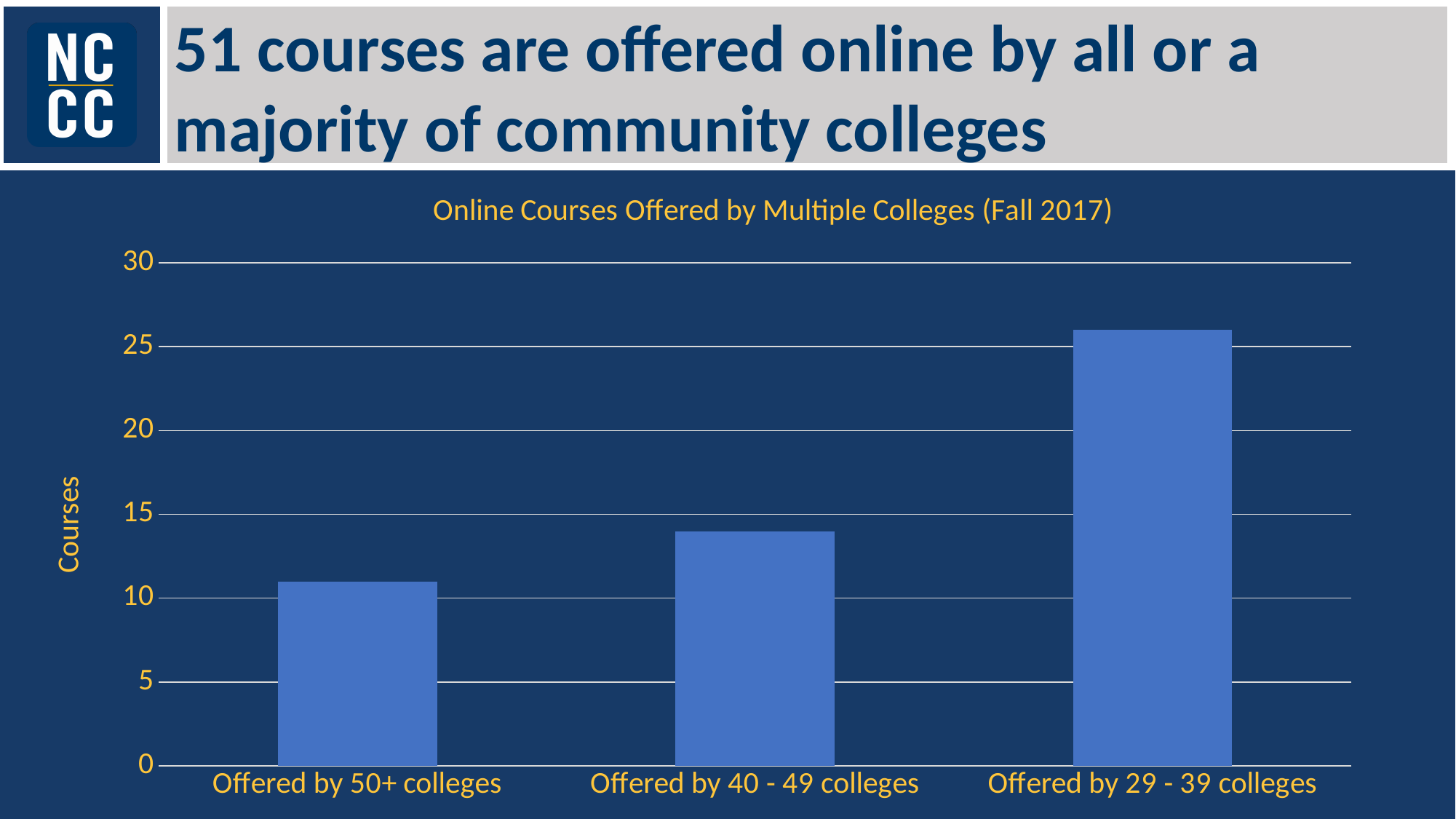
Do the values rise or fall moving from left to right across the categories? rise Which category has the highest number of courses? Offered by 29 - 39 colleges How many categories are shown on the x axis of the chart? 3 Is the value for Offered by 40 - 49 colleges greater or less than 10? greater What is the title of the chart? Online Courses Offered by Multiple Colleges (Fall 2017) Is the value for Offered by 50+ colleges greater or less than 15? less What kind of chart is shown on the slide? bar chart Is the value for Offered by 29 - 39 colleges greater or less than 20? greater What is the label on the vertical axis of the chart? Courses Which category has the lowest number of courses? Offered by 50+ colleges Which has more courses: Offered by 40 - 49 colleges or Offered by 50+ colleges? Offered by 40 - 49 colleges